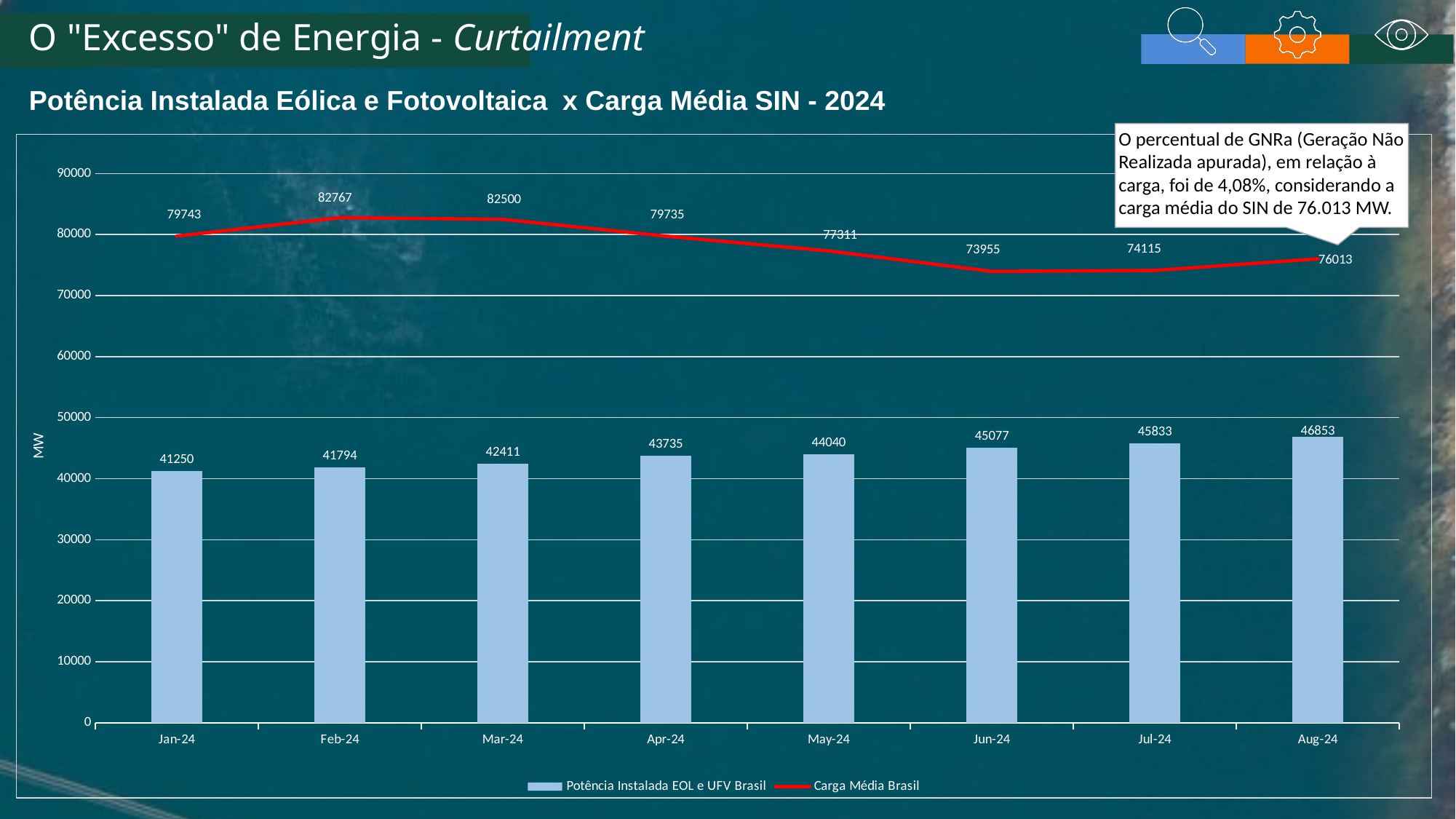
In which month is Carga Média Brasil lowest? Jun-24 What is the value of Carga Média Brasil for Feb-24? 82767 What is the value of Potência Instalada EOL e UFV Brasil for Aug-24? 46853 Which is larger: Carga Média Brasil in Jan-24 or in Apr-24? Jan-24 Does Potência Instalada EOL e UFV Brasil rise or fall from Jan-24 to Aug-24? rise What colour is the Carga Média Brasil line? red What is the difference between Potência Instalada EOL e UFV Brasil in Aug-24 and Jan-24? 5603 How many series does the legend list? 2 What unit is shown on the y axis label? MW In which month is Potência Instalada EOL e UFV Brasil highest? Aug-24 How many months are shown on the x axis? 8 What is the value of Potência Instalada EOL e UFV Brasil for Apr-24? 43735